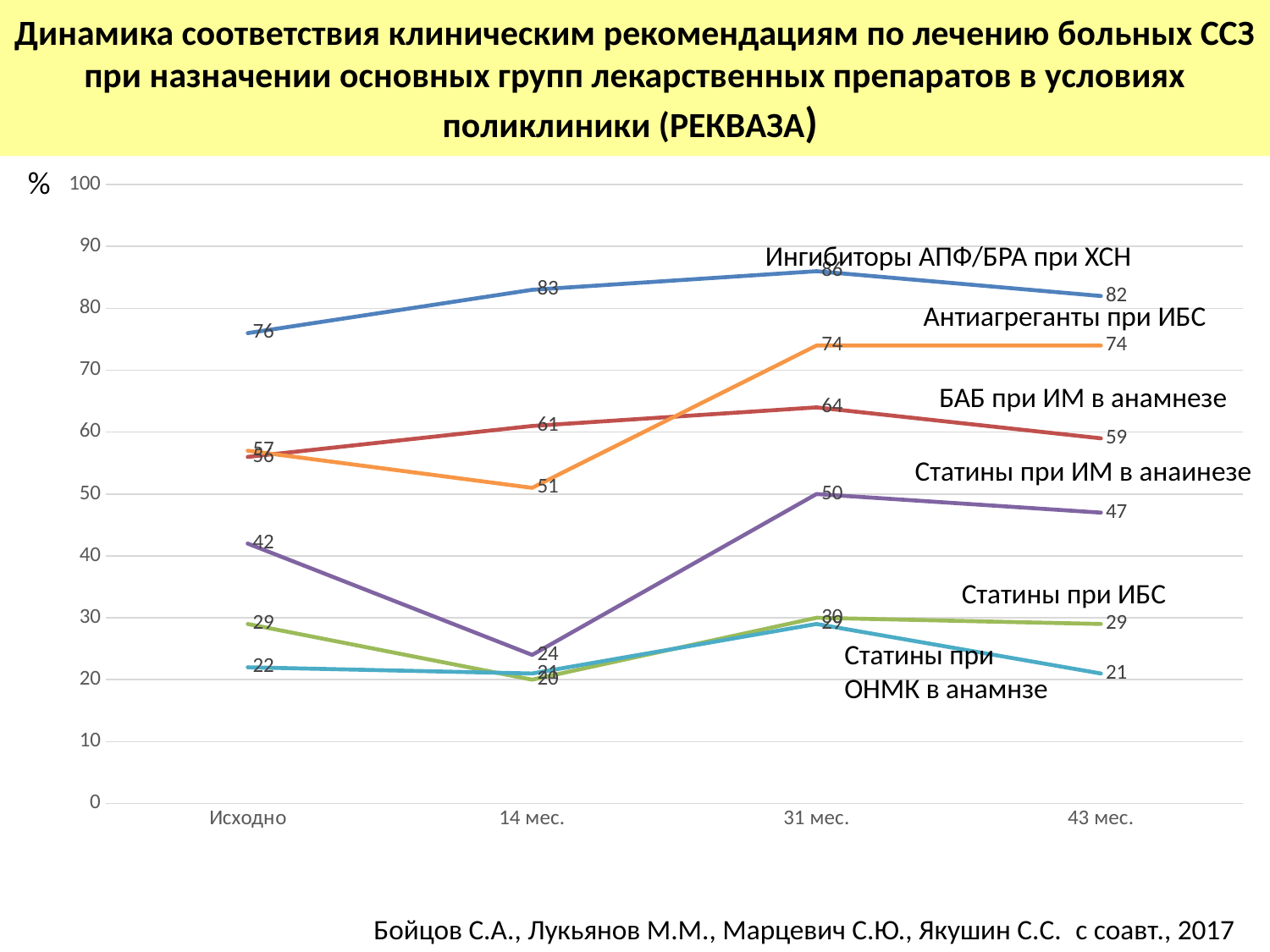
What kind of chart is shown on the slide? line chart At 43 мес., which is larger: Статины при ИМ в анаинезе or Статины при ИБС? Статины при ИМ в анаинезе What is the value for Статины при ИМ в анаинезе at Исходно? 42 What is the value for Антиагреганты при ИБС at 14 мес.? 51 Which series has the lowest value at 43 мес.? Статины при ОНМК в анамнзе How many series (lines) are plotted on the chart? 6 By how much did Антиагреганты при ИБС increase from 14 мес. to 31 мес.? 23 What is the value for БАБ при ИМ в анамнезе at 31 мес.? 64 What is the value for Ингибиторы АПФ/БРА при ХСН at 43 мес.? 82 Does the value for Ингибиторы АПФ/БРА при ХСН rise or fall from Исходно to 31 мес.? rise Which series has the highest value at 43 мес.? Ингибиторы АПФ/БРА при ХСН How many time points are shown on the x axis? 4